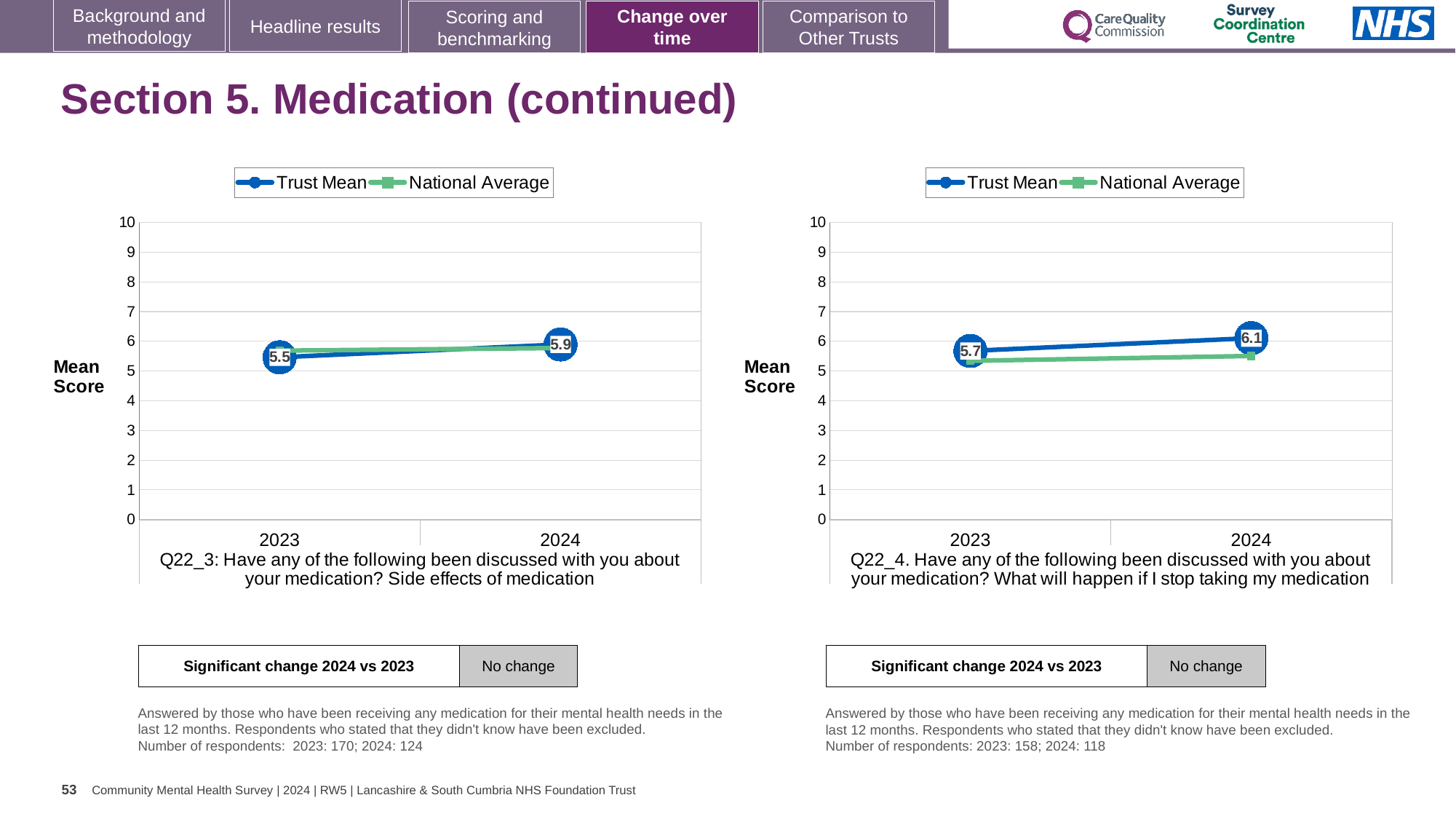
In the right chart (Q22_4), what is the Trust Mean for 2023? 5.7 In the left chart (Q22_3), what is the Trust Mean for 2024? 5.9 In the right chart (Q22_4), does the Trust Mean rise or fall from 2023 to 2024? rise In the right chart (Q22_4), is the National Average for 2024 greater or less than 6? less What kind of chart is the left chart (Q22_3)? line chart In the right chart (Q22_4), which series has the higher value in 2024, Trust Mean or National Average? Trust Mean How many years are shown on the x axis of the right chart (Q22_4)? 2 In the right chart (Q22_4), what is the Trust Mean for 2024? 6.1 In the left chart (Q22_3), by how much did the Trust Mean change from 2023 to 2024? 0.4 How many series does the legend of the left chart (Q22_3) list? 2 In the left chart (Q22_3), what is the Trust Mean for 2023? 5.5 In the right chart (Q22_4), what is the difference between the Trust Mean in 2024 and 2023? 0.4